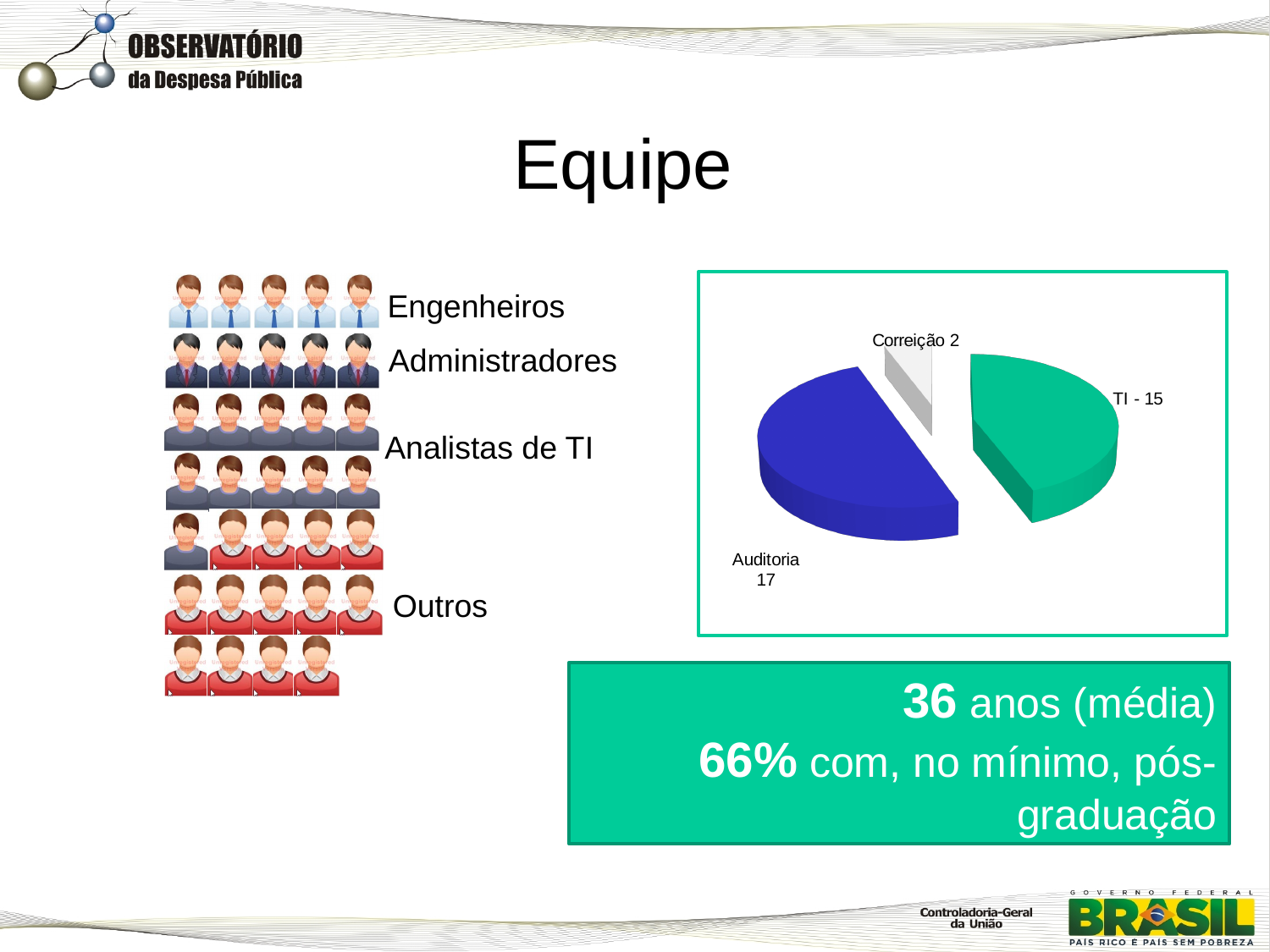
What is the value for Correição in the pie chart? 2 What share of the pie does the Auditoria slice represent? 50% What is the value for TI in the pie chart? 15 Which category has the largest slice in the pie chart? Auditoria Which category has the smallest slice in the pie chart? Correição What is the value for Auditoria in the pie chart? 17 What is the difference between the Auditoria and TI values in the pie chart? 2 Which is larger in the pie chart, Auditoria or TI? Auditoria What is the difference between the TI and Correição values in the pie chart? 13 What kind of chart is shown on the slide? pie chart What is the total of all slices in the pie chart? 34 How many slices does the pie chart have? 3